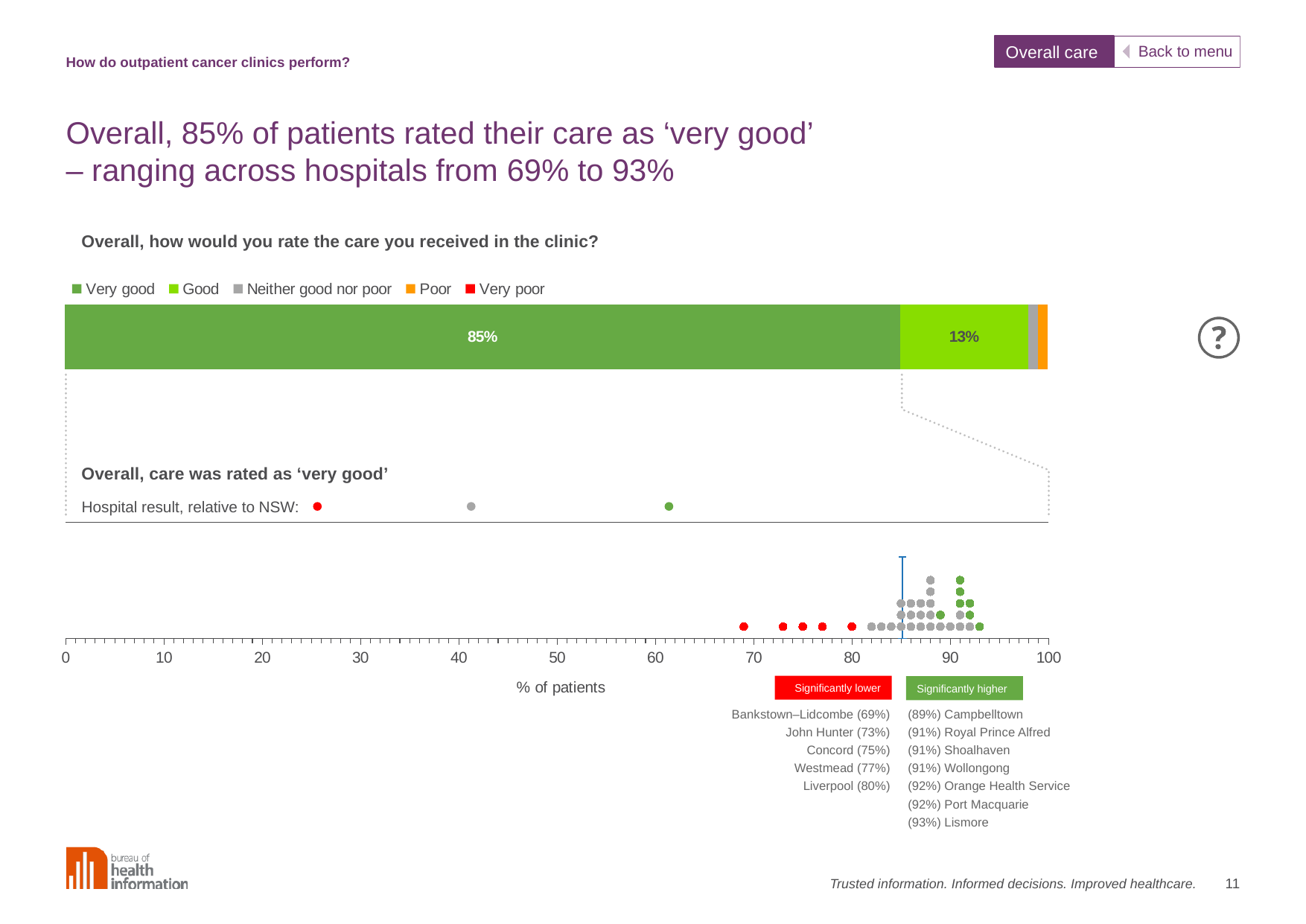
In the dot plot 'Overall, care was rated as very good', which has the higher result, Westmead or Concord? Westmead In the stacked bar chart 'Overall, how would you rate the care you received in the clinic?', how many percentage points higher is 'Very good' than 'Good'? 72 percentage points What kind of chart is the top chart 'Overall, how would you rate the care you received in the clinic?'? Stacked bar chart In the dot plot 'Overall, care was rated as very good', what is the result for Liverpool? 80% In the dot plot 'Overall, care was rated as very good', which hospital has the highest percentage of patients rating care as 'very good'? Lismore In the dot plot 'Overall, care was rated as very good', how many hospitals are listed as significantly lower than NSW? 5 How many response categories does the legend of the stacked bar chart 'Overall, how would you rate the care you received in the clinic?' list? 5 In the stacked bar chart 'Overall, how would you rate the care you received in the clinic?', what percentage of patients rated their care as 'Good'? 13% In the dot plot 'Overall, care was rated as very good', what is the difference in percentage points between Lismore and Bankstown–Lidcombe? 24 percentage points In the dot plot 'Overall, care was rated as very good', how many hospitals are listed as significantly higher than NSW? 7 In the dot plot 'Overall, care was rated as very good', which hospital has the lowest percentage of patients rating care as 'very good'? Bankstown–Lidcombe In the stacked bar chart 'Overall, how would you rate the care you received in the clinic?', what percentage of patients rated their care as 'Very good'? 85%